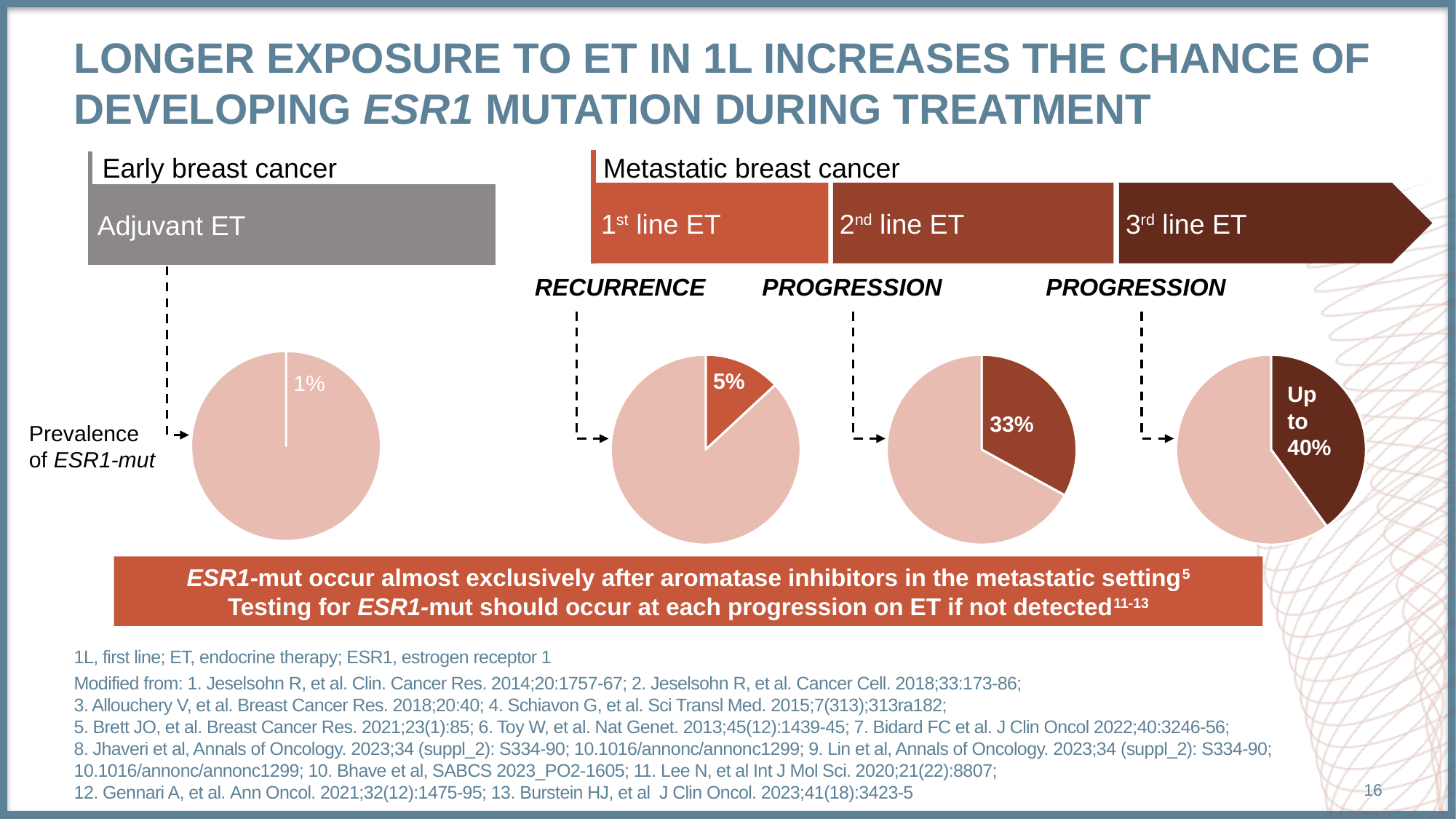
What is the difference in ESR1-mut prevalence between the 2nd line ET pie chart and the 1st line ET pie chart? 28% What is the prevalence of ESR1-mut shown in the pie chart under 3rd line ET? Up to 40% Does the prevalence of ESR1-mut rise or fall moving from Adjuvant ET through 1st, 2nd and 3rd line ET? Rise What is the prevalence of ESR1-mut shown in the pie chart under Adjuvant ET (early breast cancer)? 1% What type of chart is used to show the prevalence of ESR1-mut at each treatment stage? Pie chart What is the prevalence of ESR1-mut shown in the pie chart under 2nd line ET? 33% Which treatment stage's pie chart shows the highest prevalence of ESR1-mut? 3rd line ET Which treatment stage's pie chart shows the lowest prevalence of ESR1-mut? Adjuvant ET What label is written to the left of the pie charts describing what they show? Prevalence of ESR1-mut Which shows a larger ESR1-mut prevalence, the pie chart under 1st line ET or the pie chart under 2nd line ET? 2nd line ET What is the prevalence of ESR1-mut shown in the pie chart under 1st line ET? 5% How many pie charts are shown on the slide? 4